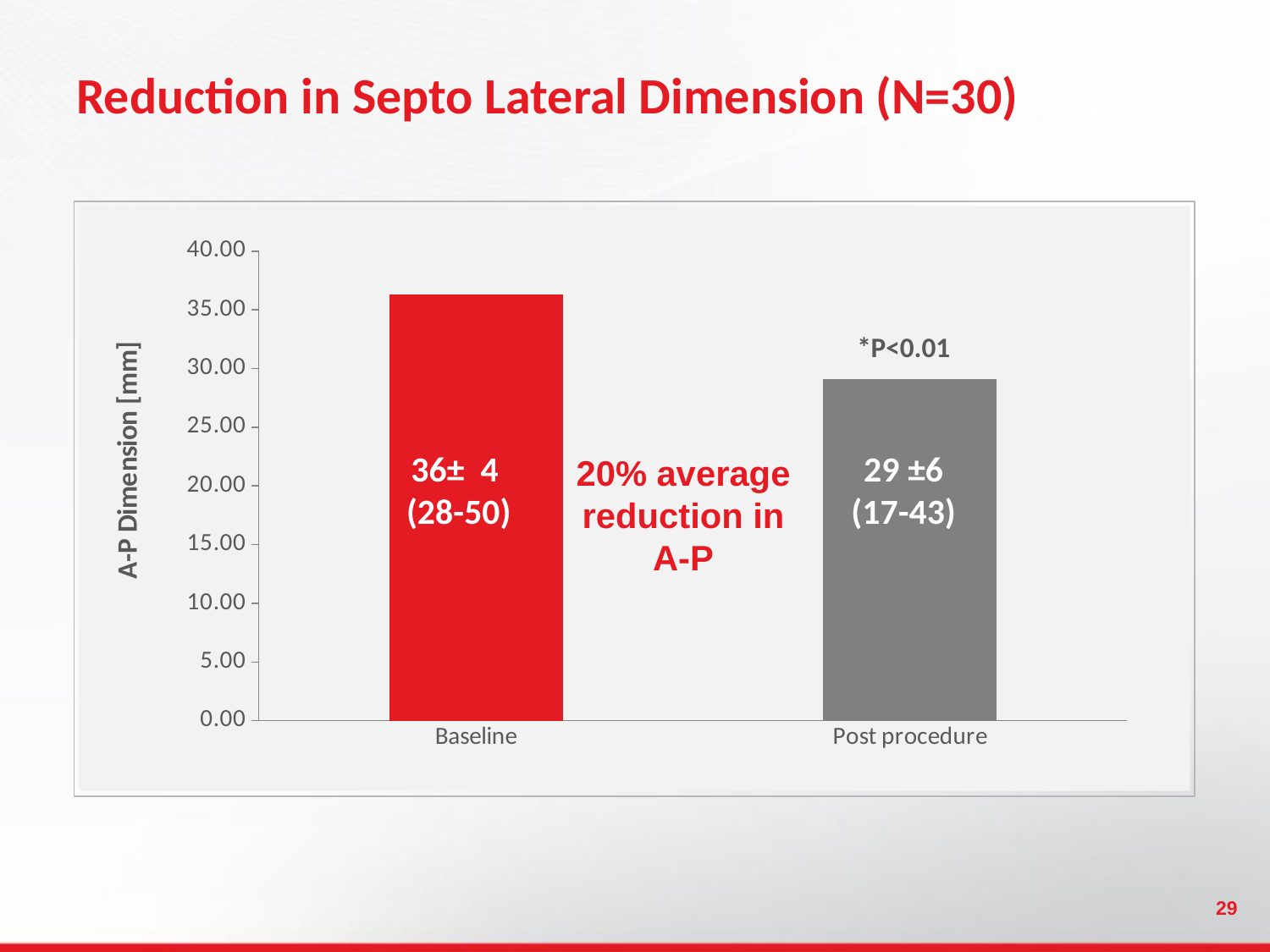
Which category has the lowest A-P dimension? Post procedure What is the label of the y axis? A-P Dimension [mm] What kind of chart is shown on the slide? bar chart Which category has the highest A-P dimension? Baseline Is the value for Post procedure greater or less than 30.00? less Do the values rise or fall from Baseline to Post procedure? fall What value is labelled on the Baseline bar? 36± 4 (28-50) Which is larger, the Baseline value or the Post procedure value? Baseline What average reduction in A-P is stated between the two bars? 20% How many categories are plotted on the x axis? 2 Is the value for Baseline greater or less than 35.00? greater What value is labelled on the Post procedure bar? 29 ±6 (17-43)